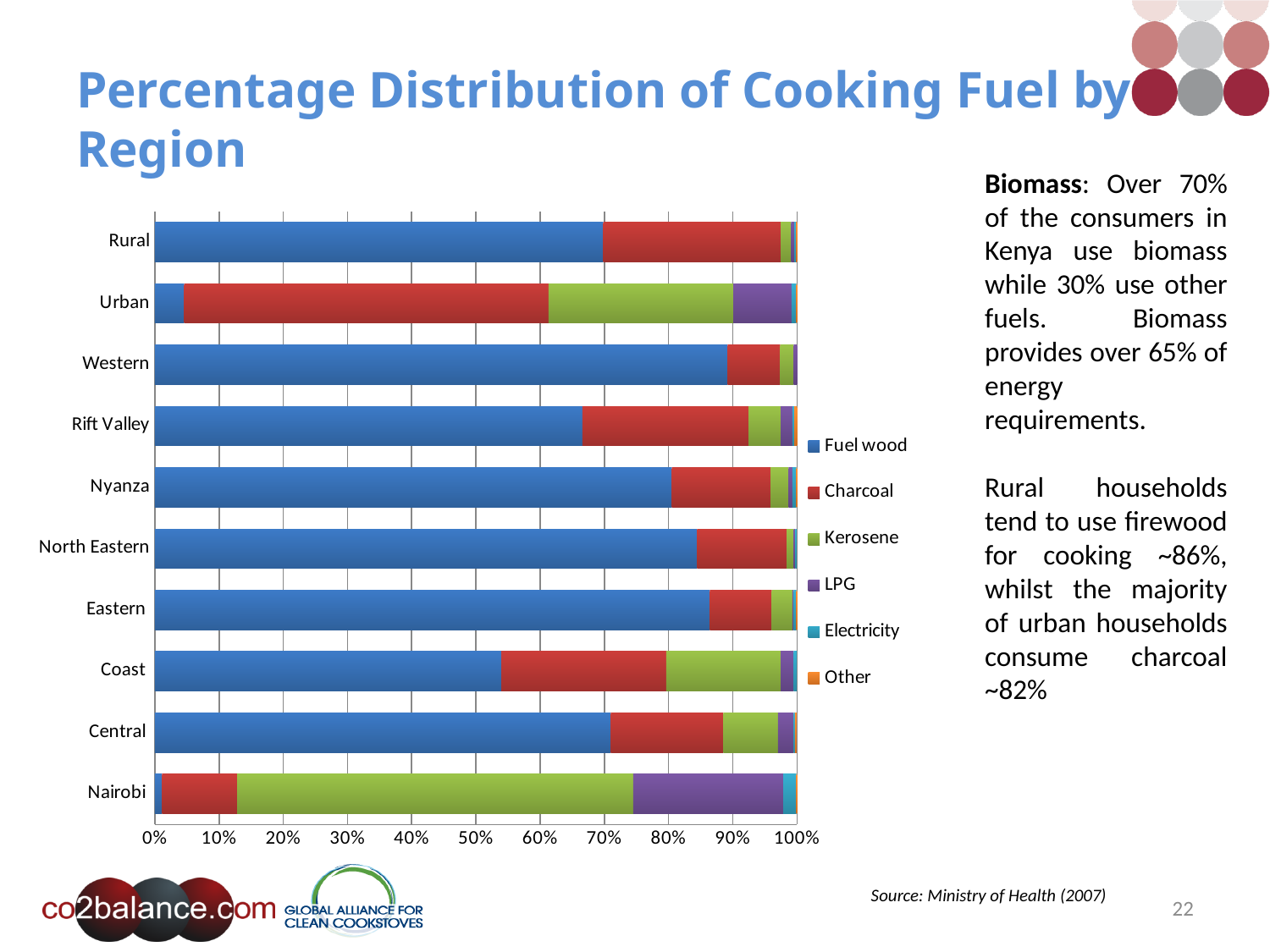
Is the Fuel wood share for Western greater or less than 80%? greater Which has the larger Kerosene share, Nairobi or Coast? Nairobi Is the Fuel wood share for Coast greater or less than 50%? greater Is the Fuel wood share for Urban greater or less than 10%? less Which region has the smallest Fuel wood share? Nairobi What kind of chart is shown on the slide? Stacked bar chart What colour represents Charcoal in the legend? Red Which region has the largest LPG share? Nairobi Which has the larger Charcoal share, Urban or Rural? Urban How many regions (categories) are plotted on the chart? 10 How many series does the legend list? 6